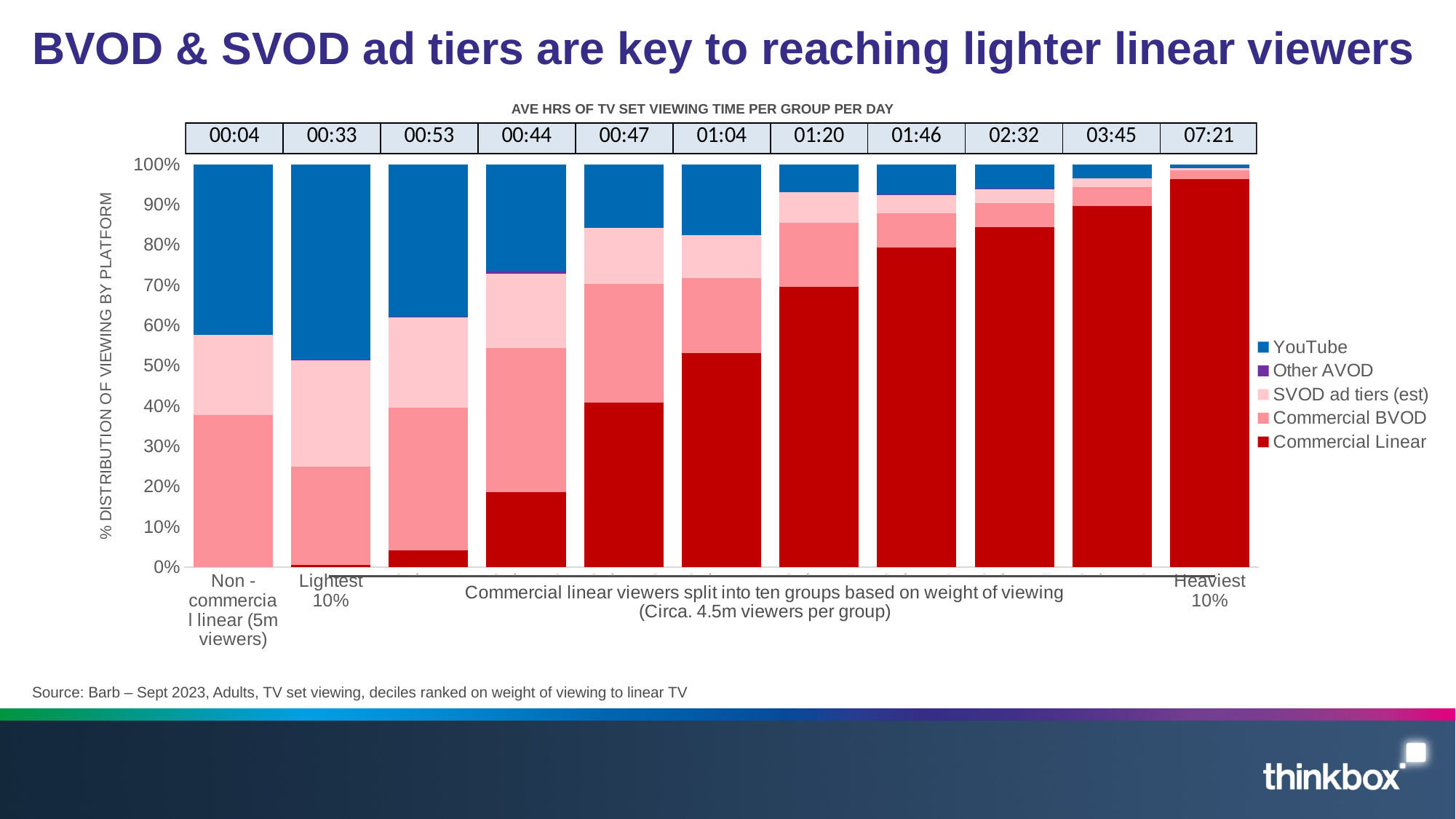
What is the label on the vertical axis of the chart? % DISTRIBUTION OF VIEWING BY PLATFORM Is the Commercial Linear share for the Heaviest 10% group greater or less than 90%? greater Is the Commercial Linear share for the Lightest 10% group greater or less than 10%? less What is the average hours of TV set viewing time per day shown for the Lightest 10% group? 00:33 What is the average hours of TV set viewing time per day shown for the Non-commercial linear (5m viewers) group? 00:04 Does the Commercial Linear share rise or fall moving from the Lightest 10% group to the Heaviest 10% group? Rises How many bars (viewer groups) are plotted in the chart? 11 What kind of chart is shown on the slide? Stacked bar chart Which group has the largest Commercial Linear share of viewing? Heaviest 10% Which group has the largest YouTube share of viewing? Lightest 10% How many series does the legend list? 5 What is the average hours of TV set viewing time per day shown for the Heaviest 10% group? 07:21